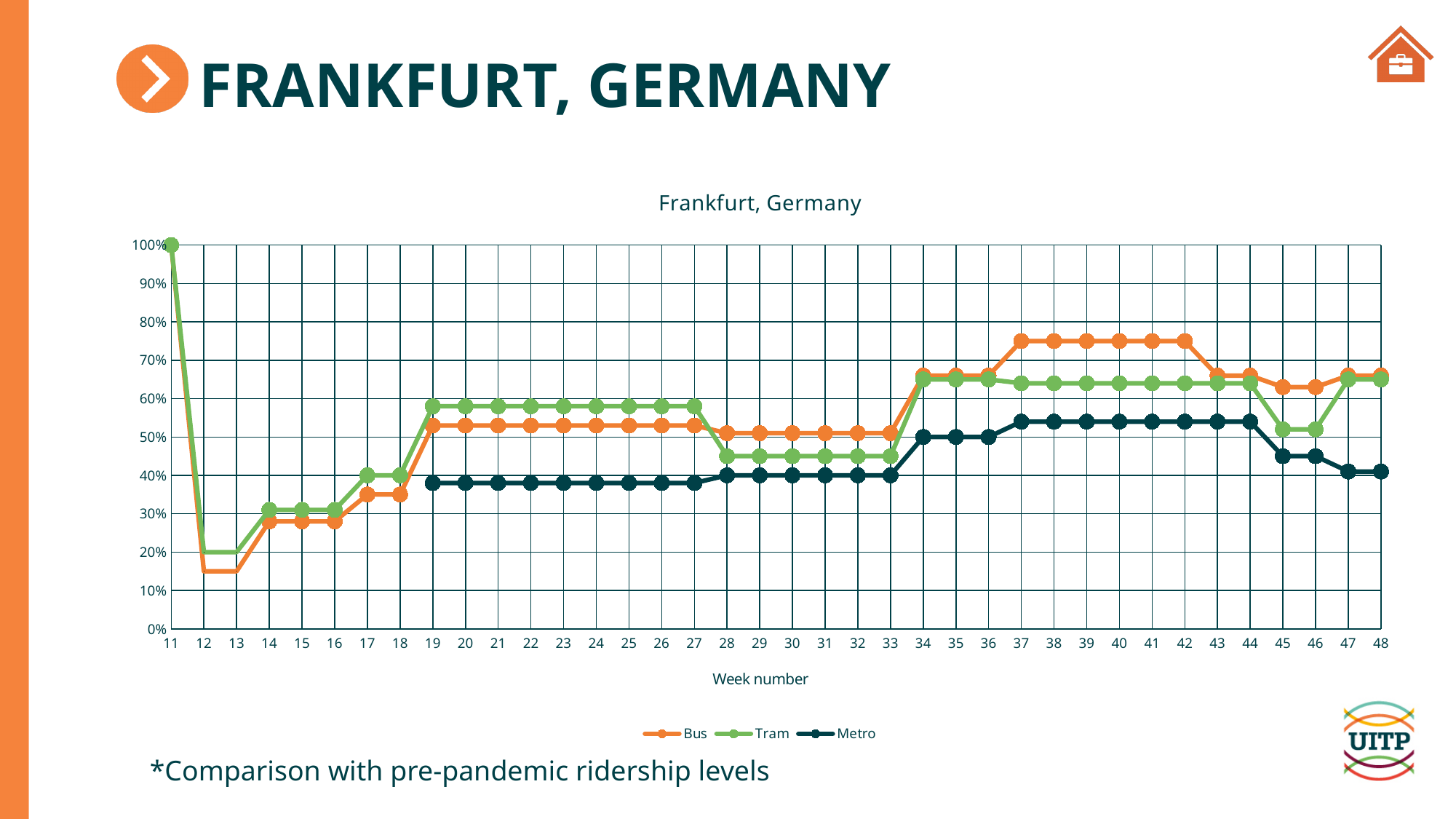
What is the Metro value at week 30? 40% What are the three series named in the legend? Bus, Tram, Metro How many series does the legend list? 3 Which series has the lowest value at week 38? Metro Is the Metro value at week 45 greater or less than 50%? less Does the Bus series rise or fall between week 12 and week 19? rise What is the Metro value at week 35? 50% What is the label of the x axis? Week number Is the Bus value at week 40 greater or less than 70%? greater What is the Tram value at week 12? 20% At week 40, which is larger, the Bus value or the Tram value? Bus What kind of chart is shown on the slide? line chart